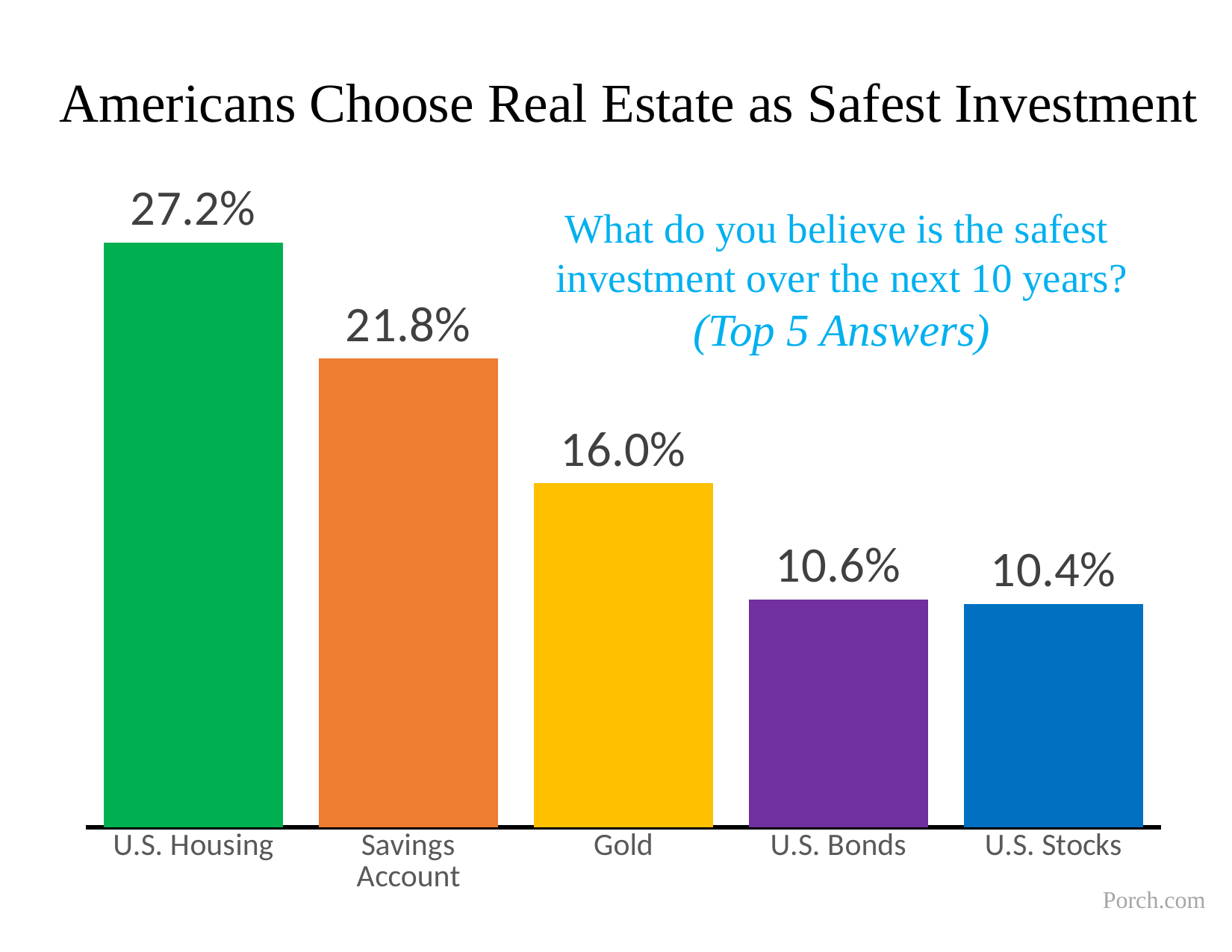
What is the value shown for U.S. Stocks? 10.4% What is the difference between the values for Gold and U.S. Bonds? 5.4% What is the title of the slide? Americans Choose Real Estate as Safest Investment How many categories are shown in the chart? 5 Which is larger, the value for Savings Account or the value for Gold? Savings Account What is the difference between the values for U.S. Housing and Savings Account? 5.4% Which category has the lowest value? U.S. Stocks What kind of chart is shown on the slide? Bar chart What is the value shown for Savings Account? 21.8% What is the value shown for Gold? 16.0% Which category has the highest value? U.S. Housing What percentage of respondents chose U.S. Housing as the safest investment? 27.2%